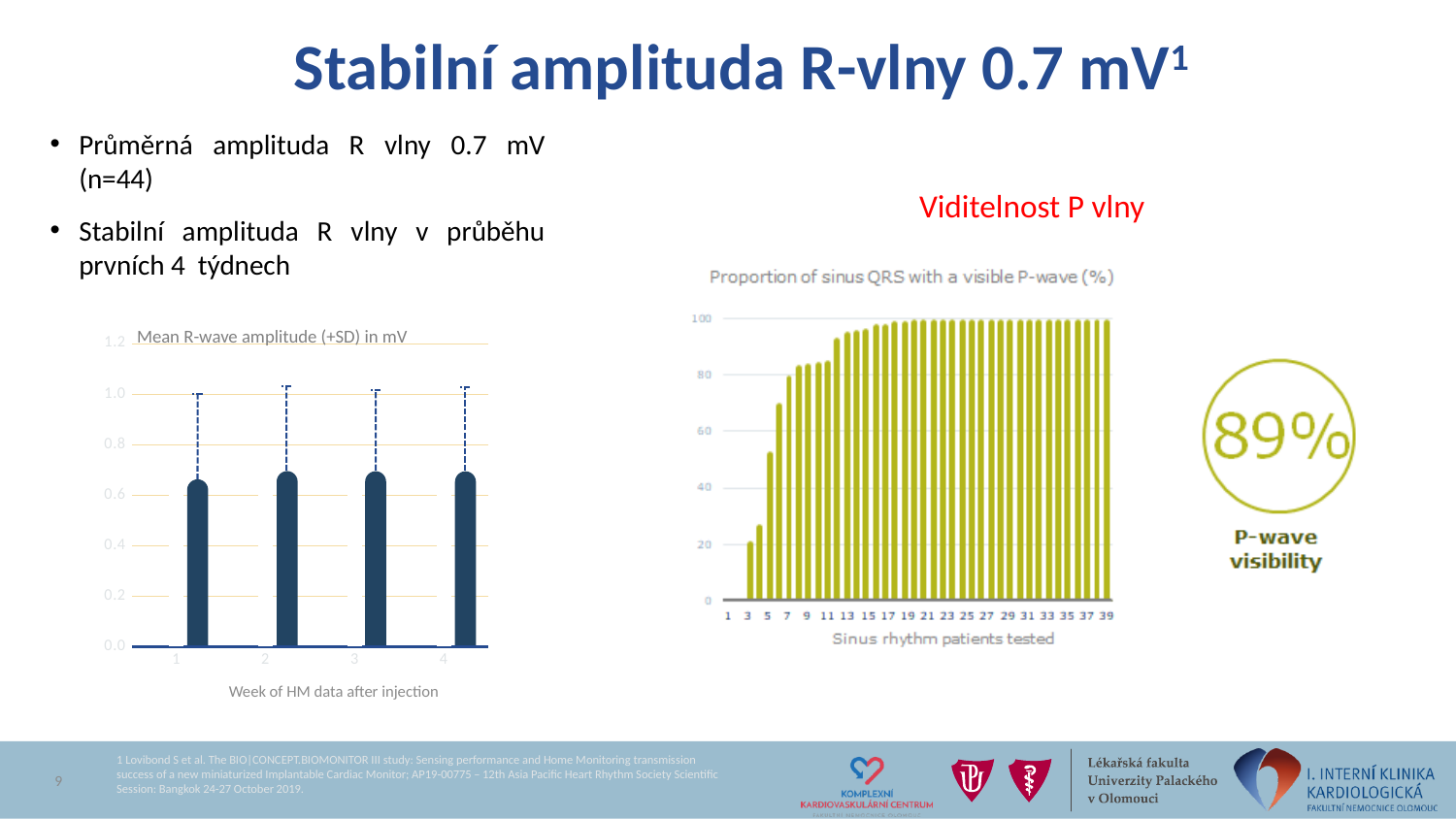
What is the x-axis label of the left chart "Mean R-wave amplitude (+SD) in mV"? Week of HM data after injection In the right chart "Proportion of sinus QRS with a visible P-wave (%)", which is larger: the value for patient 5 or the value for patient 25? patient 25 What kind of chart is the left chart titled "Mean R-wave amplitude (+SD) in mV"? bar chart What kind of chart is the right chart titled "Proportion of sinus QRS with a visible P-wave (%)"? bar chart In the left chart "Mean R-wave amplitude (+SD) in mV", is the value for week 1 greater or less than 0.8? less How many weeks (bars) are plotted in the left chart "Mean R-wave amplitude (+SD) in mV"? 4 In the right chart "Proportion of sinus QRS with a visible P-wave (%)", is the value for patient 1 greater or less than 40? less What is the x-axis label of the right chart "Proportion of sinus QRS with a visible P-wave (%)"? Sinus rhythm patients tested In the right chart "Proportion of sinus QRS with a visible P-wave (%)", do the values rise or fall as the number of sinus rhythm patients tested increases? rise In the left chart "Mean R-wave amplitude (+SD) in mV", is the value for week 4 greater or less than 0.4? greater